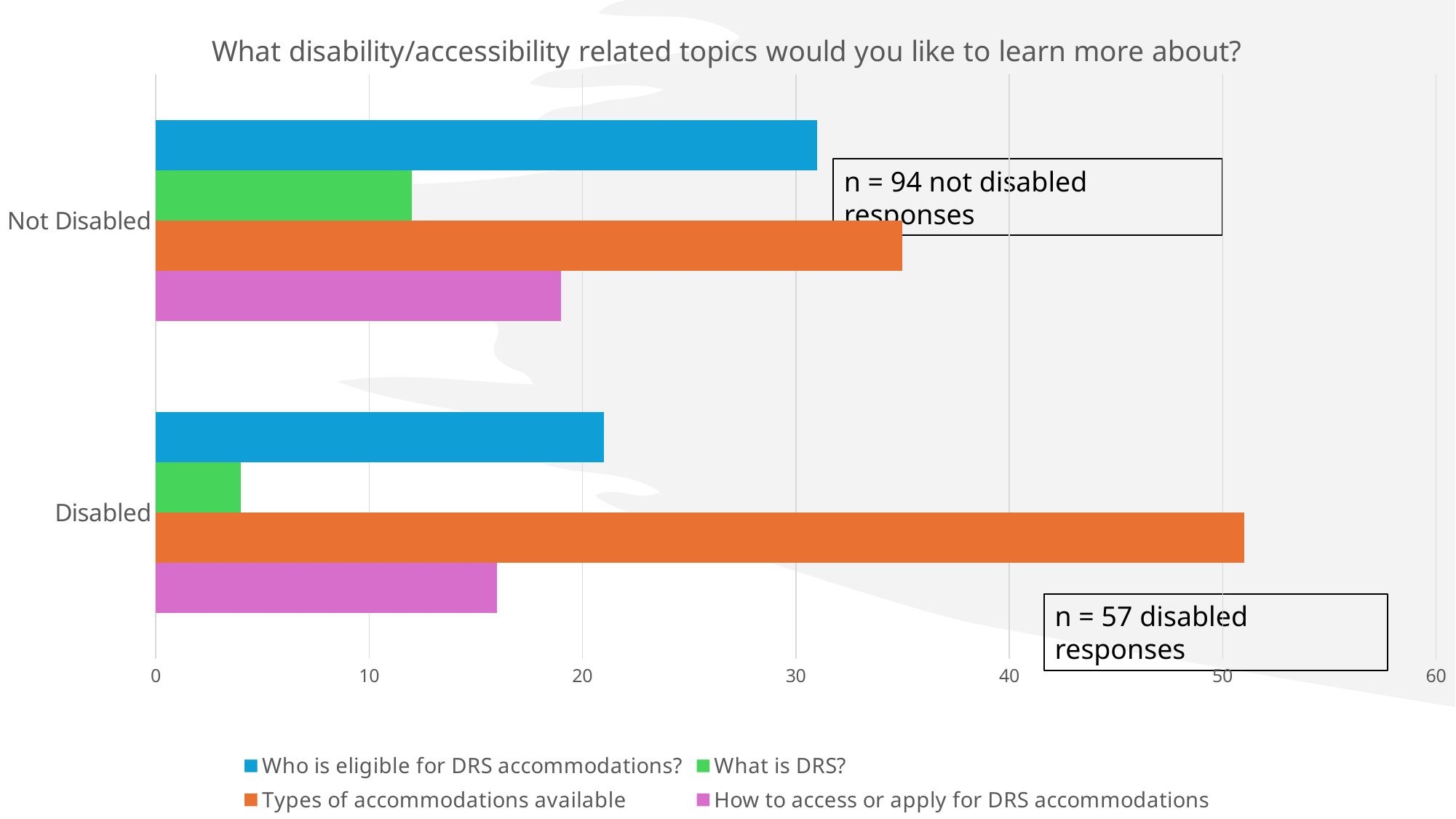
Is the value for 'What is DRS?' in the Disabled category greater or less than 10? less Which series has the shortest bar for the Not Disabled category? What is DRS? Which series has the longest bar for the Not Disabled category? Types of accommodations available For 'Types of accommodations available', which category has the larger value, Disabled or Not Disabled? Disabled How many categories are shown on the vertical axis? 2 What is the title of the chart? What disability/accessibility related topics would you like to learn more about? Is the value for 'Who is eligible for DRS accommodations?' in the Not Disabled category greater or less than 30? greater Which series has the shortest bar for the Disabled category? What is DRS? Is the value for 'Types of accommodations available' in the Disabled category greater or less than 50? greater Which series has the longest bar for the Disabled category? Types of accommodations available What kind of chart is shown on the slide? bar chart How many series does the legend list? 4